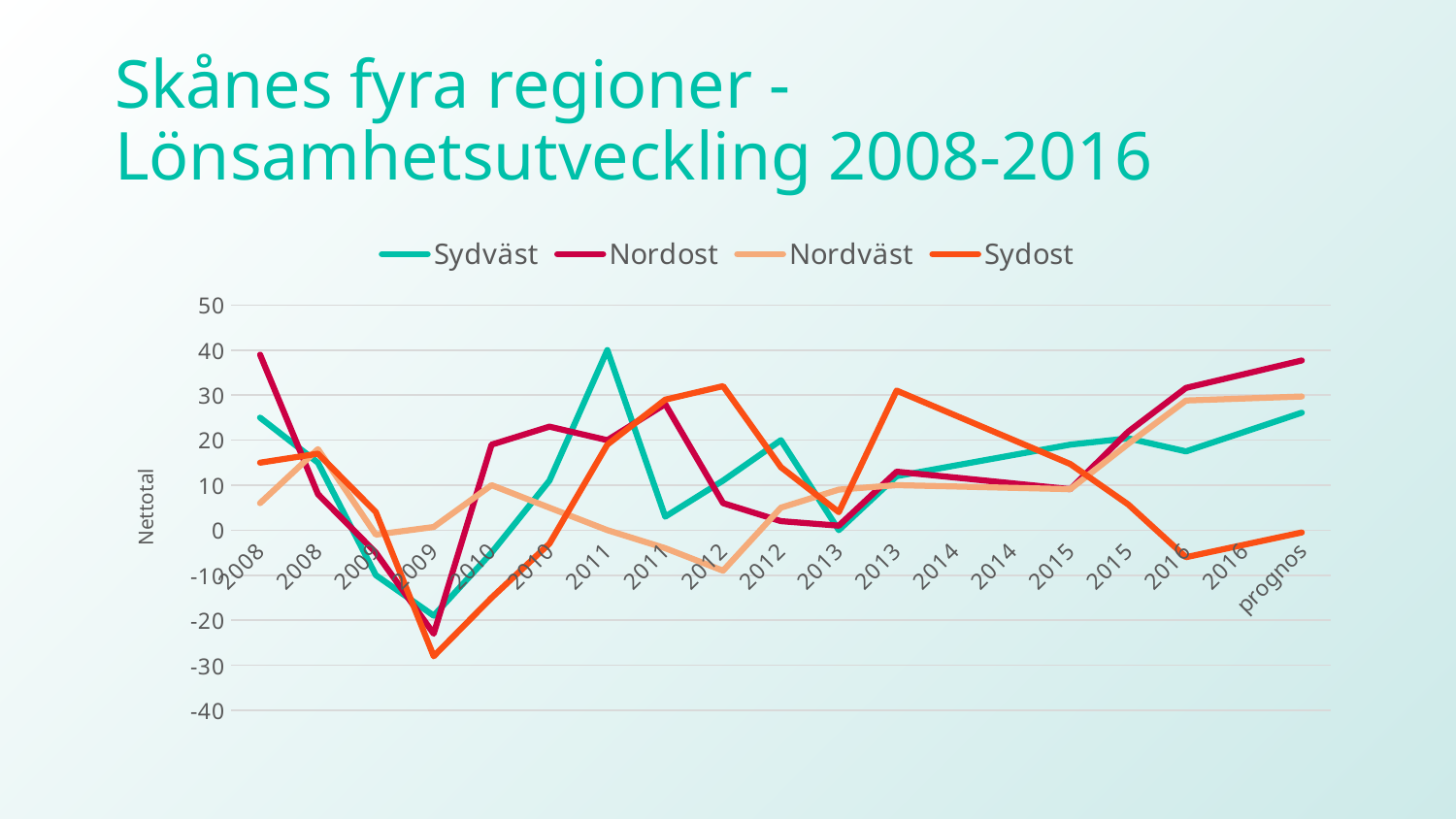
At the first 2012 point, which series has the larger value, Sydost or Nordväst? Sydost Is the value for Sydväst at the first 2011 point greater or less than 30? greater Which series has the highest value at the first 2008 point? Nordost Is the value for Nordväst at the first 2012 point greater or less than 0? less What kind of chart is shown on the slide? line chart Is the value for Sydost at the second 2009 point greater or less than -20? less At the first 2011 point, which series has the larger value, Sydväst or Nordost? Sydväst Does the Sydost line rise or fall from the second 2013 point to the first 2016 point? fall What is the label of the vertical axis? Nettotal Which series has the highest value at the prognos point? Nordost How many series does the legend list? 4 Which series has the lowest value at the prognos point? Sydost